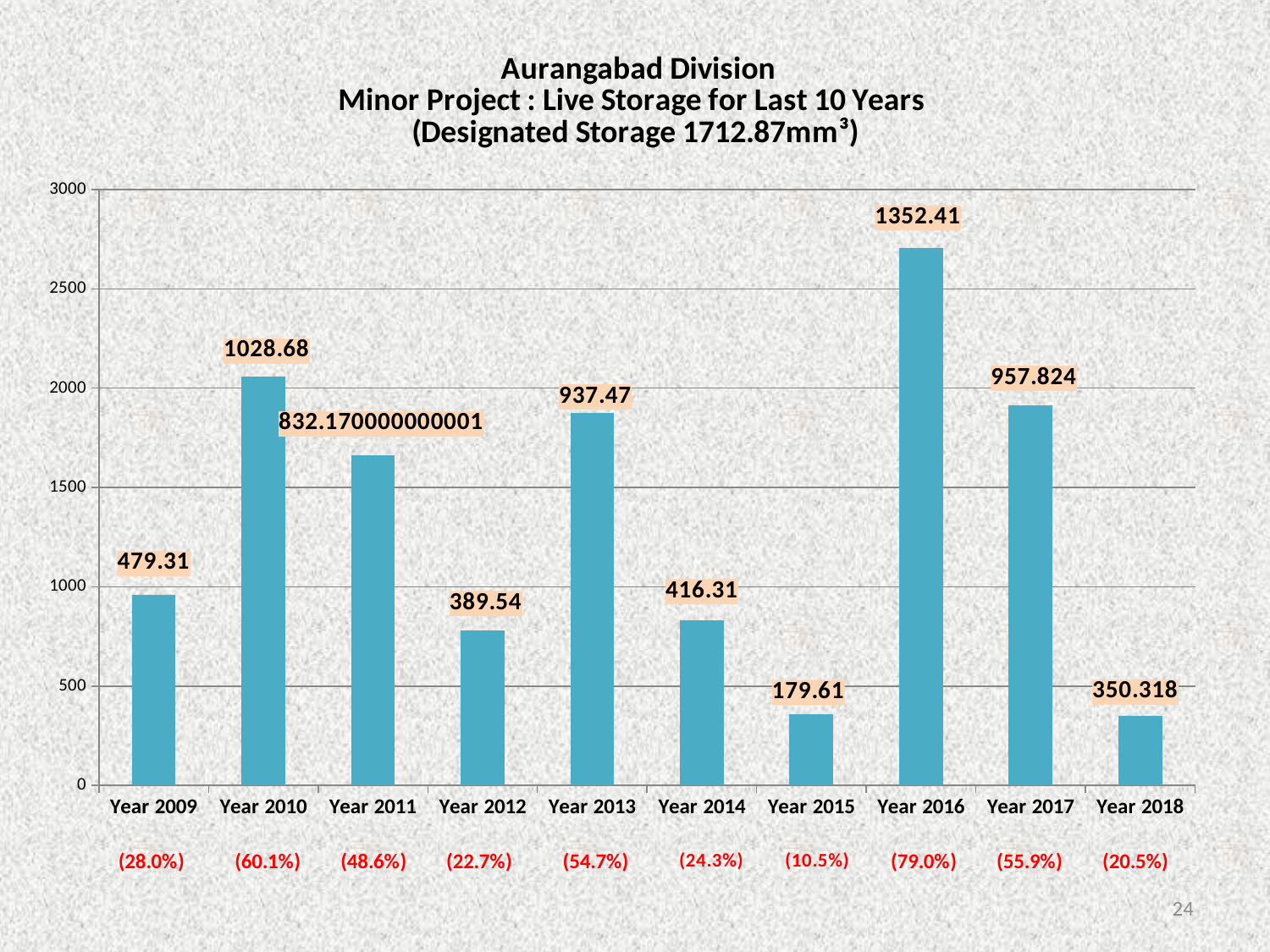
What is the live storage value shown for Year 2016? 1352.41 What is the difference between the live storage values for Year 2016 and Year 2015? 1172.80 Which year has the highest live storage value? Year 2016 What is the difference between the live storage values for Year 2010 and Year 2009? 549.37 What percentage is printed below Year 2016 on the chart? (79.0%) What is the live storage value shown for Year 2009? 479.31 How many years are shown on the x axis of the chart? 10 Which year has the larger live storage value, Year 2013 or Year 2017? Year 2017 What is the live storage value shown for Year 2018? 350.318 What kind of chart is shown on the slide? Bar chart Which year has the lowest live storage value? Year 2015 What is the live storage value shown for Year 2015? 179.61